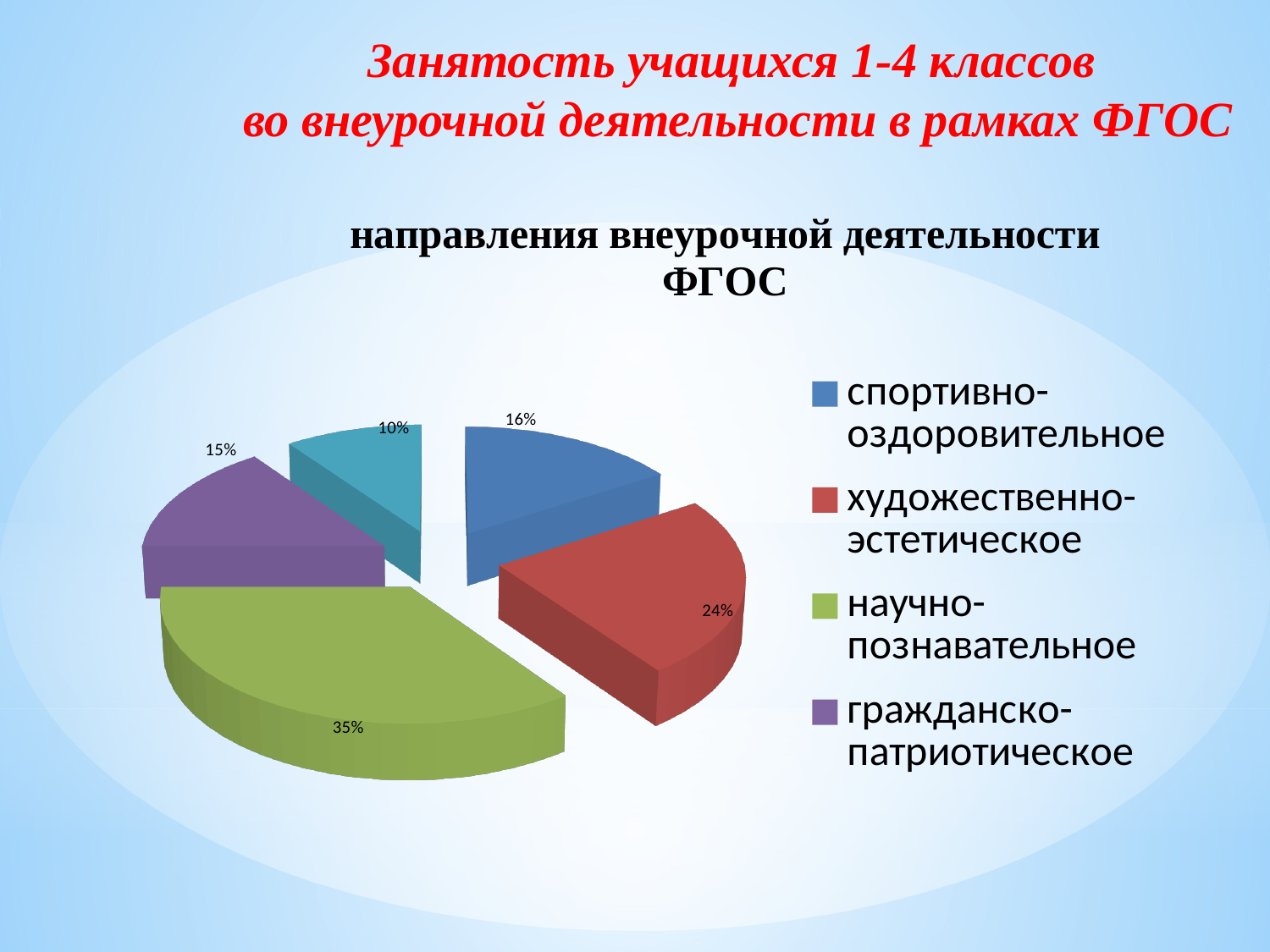
How many slices does the pie chart have? 5 What percentage does the спортивно-оздоровительное slice represent? 16% What is the smallest percentage shown on the pie chart? 10% What percentage does the научно-познавательное slice represent? 35% What percentage does the художественно-эстетическое slice represent? 24% What kind of chart is shown on the slide? pie chart What is the title of the chart? направления внеурочной деятельности ФГОС How many entries are listed in the chart legend? 4 Which category has the largest share of the pie? научно-познавательное What is the difference in percentage points between научно-познавательное and художественно-эстетическое? 11 Which is larger, the share for спортивно-оздоровительное or for гражданско-патриотическое? спортивно-оздоровительное What percentage does the гражданско-патриотическое slice represent? 15%